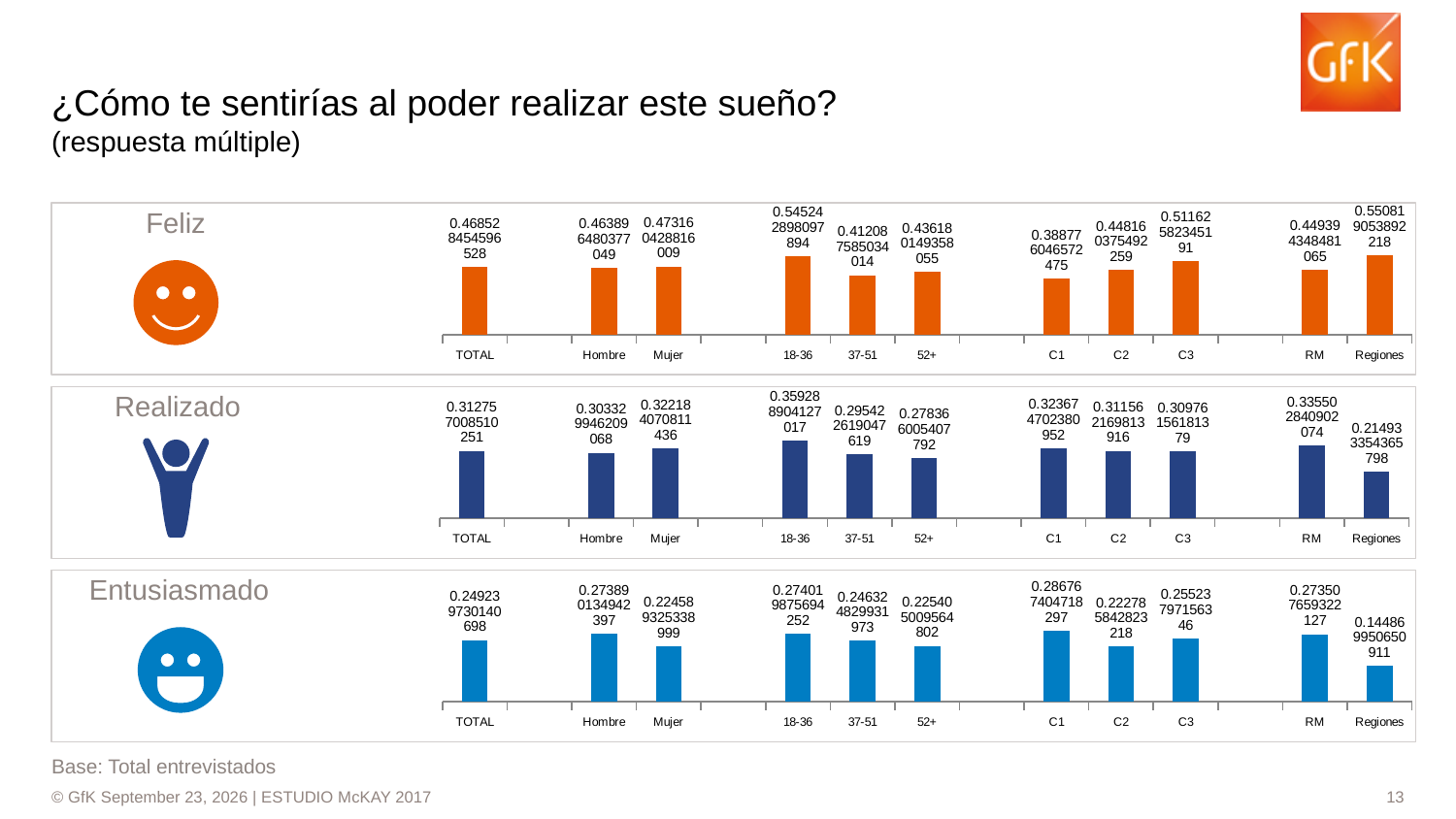
In the Entusiasmado chart, what is the value for C1? 0.286767404718297 In the Feliz chart, which category has the lowest value? C1 What kind of chart is used for the Realizado row? Bar chart In the Realizado chart, which is larger, the value for RM or the value for Regiones? RM In the Entusiasmado chart, which category has the lowest value? Regiones In the Realizado chart, which category has the highest value? 18-36 In the Entusiasmado chart, which is larger, the value for Hombre or the value for Mujer? Hombre In the Feliz chart, what is the value for 18-36? 0.545242898097894 How many categories are shown on the x axis of the Feliz chart? 11 In the Realizado chart, what is the value for Regiones? 0.214933354365798 What colour are the bars in the Feliz chart? Orange In the Feliz chart, what is the value for TOTAL? 0.468528454596528